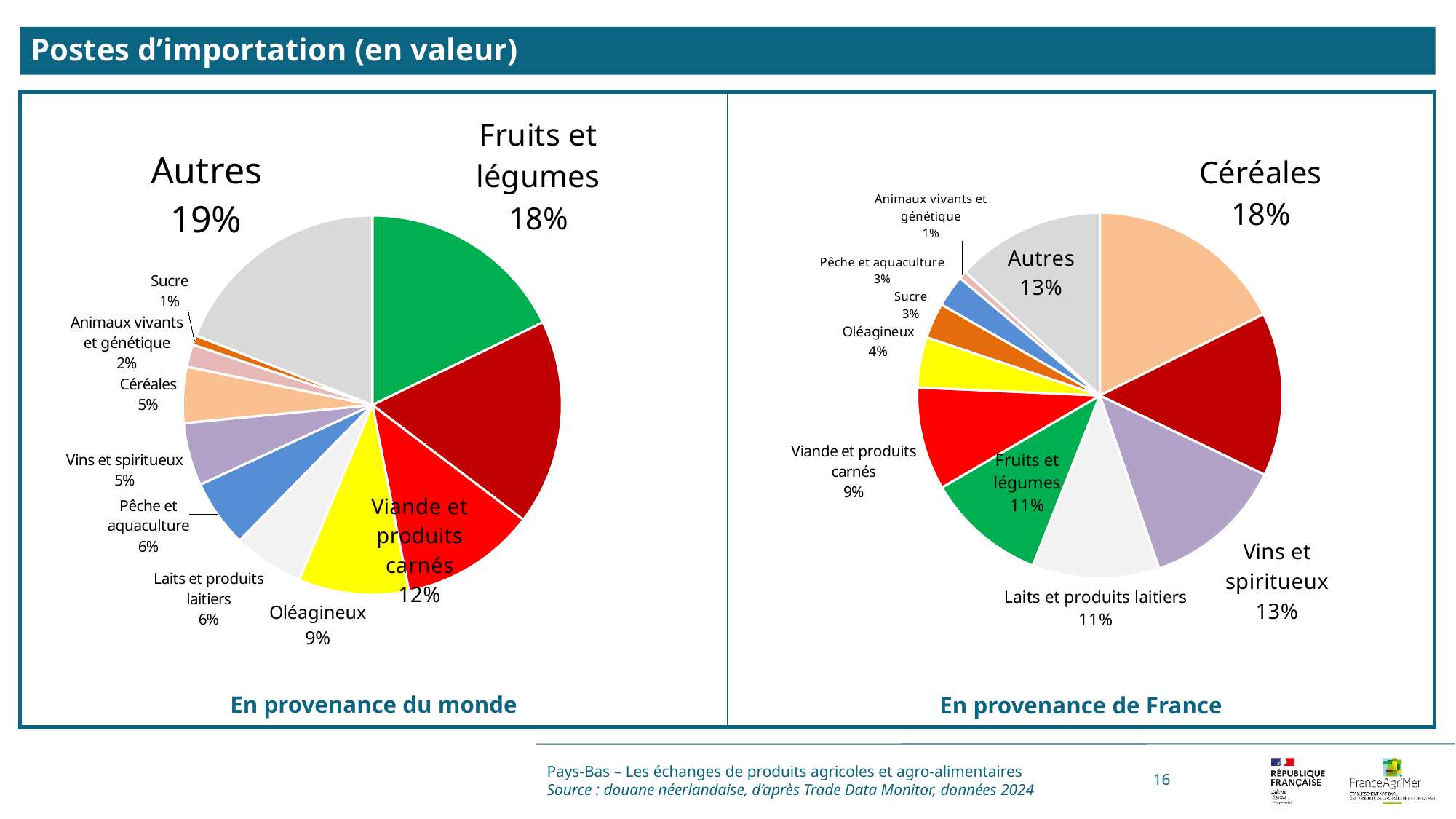
In the 'En provenance du monde' pie chart, what share is labelled for Fruits et légumes? 18% In the 'En provenance du monde' pie chart, what is the difference between the shares of Autres and Viande et produits carnés? 7% In the 'En provenance de France' pie chart, what share is labelled for Vins et spiritueux? 13% In the 'En provenance du monde' pie chart, what share is labelled for Oléagineux? 9% What is the title of the slide? Postes d'importation (en valeur) In the 'En provenance de France' pie chart, which category has the smallest share? Animaux vivants et génétique In the 'En provenance de France' pie chart, which labelled category has the largest share? Céréales In the 'En provenance de France' pie chart, what share is labelled for Viande et produits carnés? 9% In the 'En provenance du monde' pie chart, which labelled category has the largest share? Autres In the 'En provenance de France' pie chart, which is larger: the share of Céréales or the share of Laits et produits laitiers? Céréales What kind of chart is used on this slide? Pie chart In the 'En provenance du monde' pie chart, which category has the smallest share? Sucre